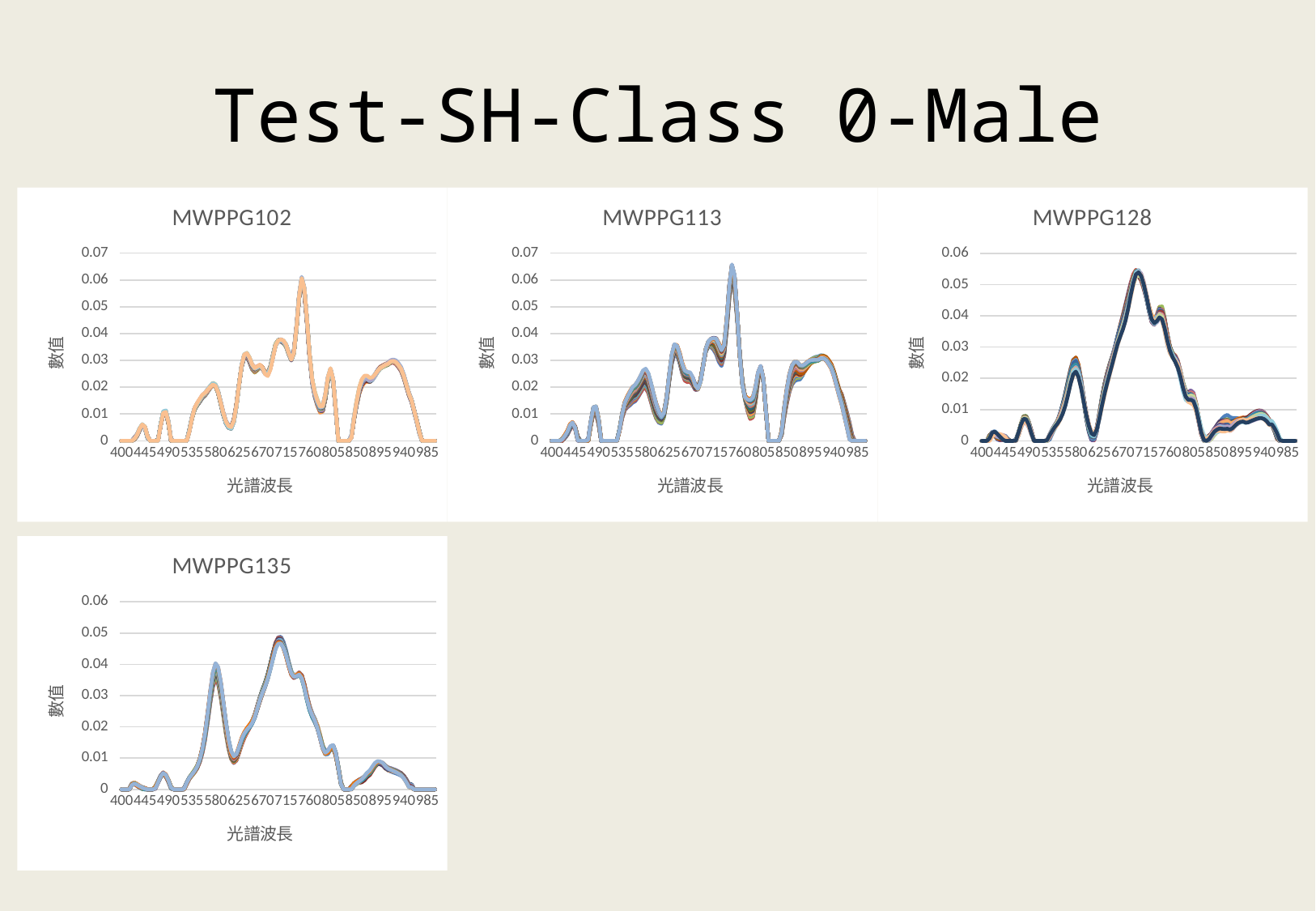
What is the highest value shown on the y-axis of the MWPPG128 chart? 0.06 In the MWPPG135 chart, is the highest peak of the lines greater or less than 0.04? greater In the MWPPG102 chart, is the highest peak of the line greater or less than 0.05? greater In the MWPPG128 chart, is the highest peak of the lines greater or less than 0.05? greater What kind of chart is MWPPG102? line chart What is the title of the chart in the bottom-left of the slide? MWPPG135 How many charts are shown on the slide? 4 What is the x-axis title of the MWPPG113 chart? 光譜波長